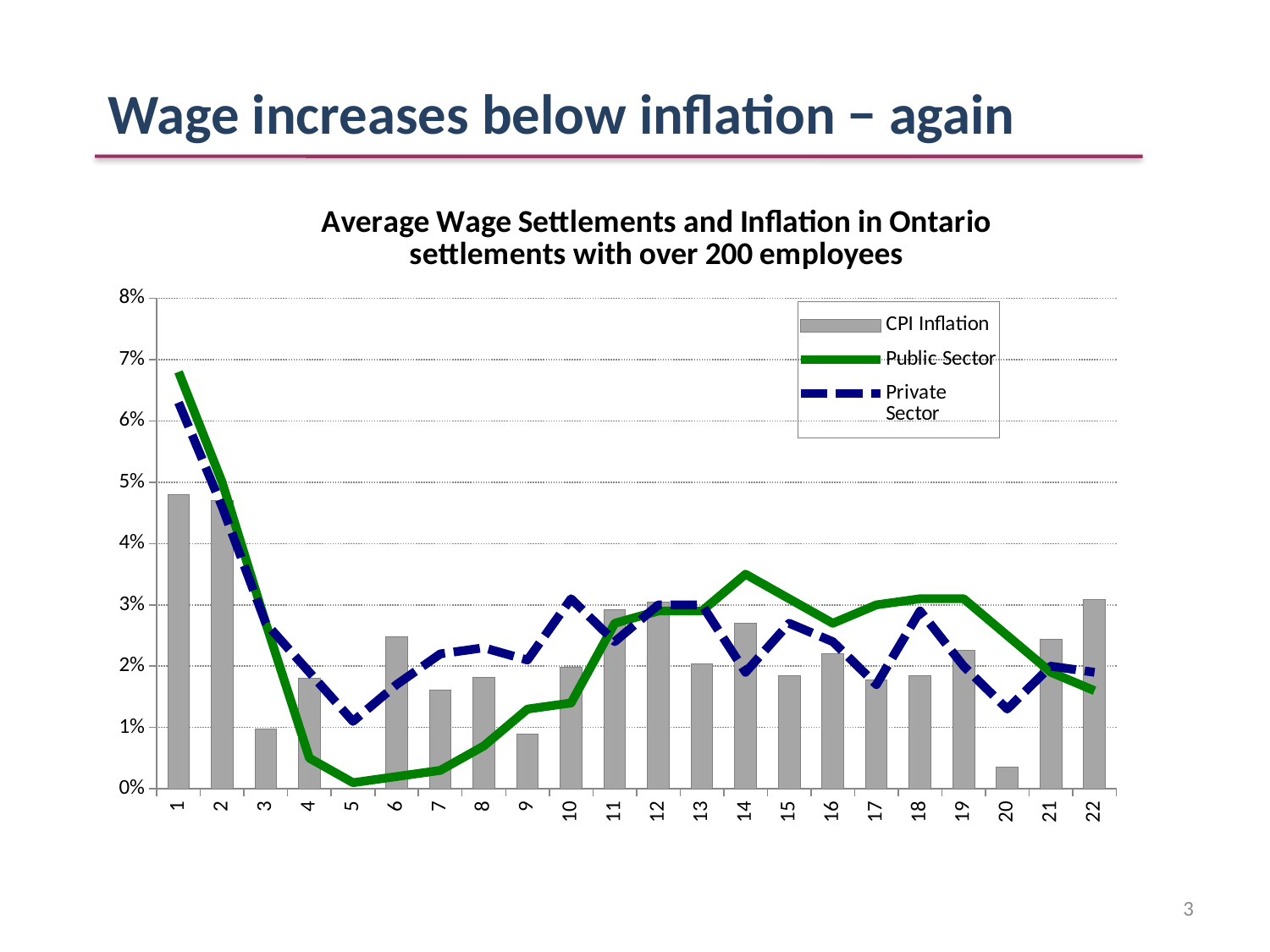
What kind of chart is this? Combination bar and line chart How many categories are shown on the x axis? 22 At which category is the Private Sector line at its highest? 1 At category 6, which is larger: CPI Inflation or Public Sector? CPI Inflation Which series is plotted as bars? CPI Inflation At which category is the Public Sector line at its lowest? 5 Does the Public Sector line rise or fall from category 1 to category 5? fall What is the title of the chart? Average Wage Settlements and Inflation in Ontario settlements with over 200 employees Is the CPI Inflation value for category 1 greater or less than 4%? greater Is the CPI Inflation value for category 20 greater or less than 1%? less How many series does the legend list? 3 Is the Public Sector value for category 14 greater or less than 3%? greater